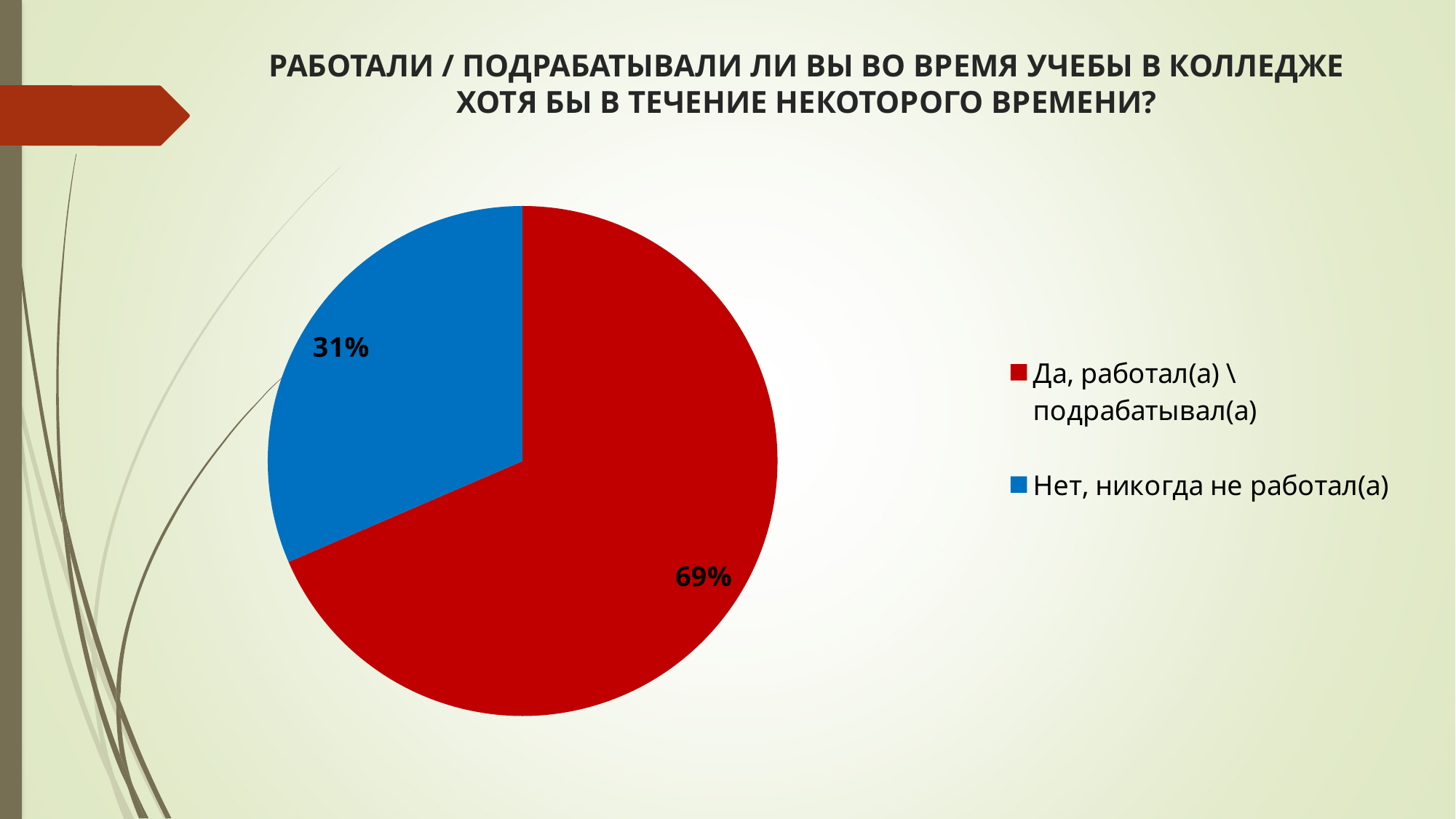
How many slices does the pie chart have? 2 What percentage of respondents answered "Да, работал(а) \ подрабатывал(а)"? 69% How many entries does the legend list? 2 What type of chart is shown on the slide? pie chart Which is larger: the share for "Да, работал(а) \ подрабатывал(а)" or the share for "Нет, никогда не работал(а)"? Да, работал(а) \ подрабатывал(а) What percentage of respondents answered "Нет, никогда не работал(а)"? 31% What share of the pie does the blue slice represent? 31% Which answer has the smallest share of the pie? Нет, никогда не работал(а) What colour is the slice for "Да, работал(а) \ подрабатывал(а)"? red Which answer has the largest share of the pie? Да, работал(а) \ подрабатывал(а) What is the title of the chart on the slide? РАБОТАЛИ / ПОДРАБАТЫВАЛИ ЛИ ВЫ ВО ВРЕМЯ УЧЕБЫ В КОЛЛЕДЖЕ ХОТЯ БЫ В ТЕЧЕНИЕ НЕКОТОРОГО ВРЕМЕНИ? What is the difference in percentage points between the "Да, работал(а) \ подрабатывал(а)" slice and the "Нет, никогда не работал(а)" slice? 38